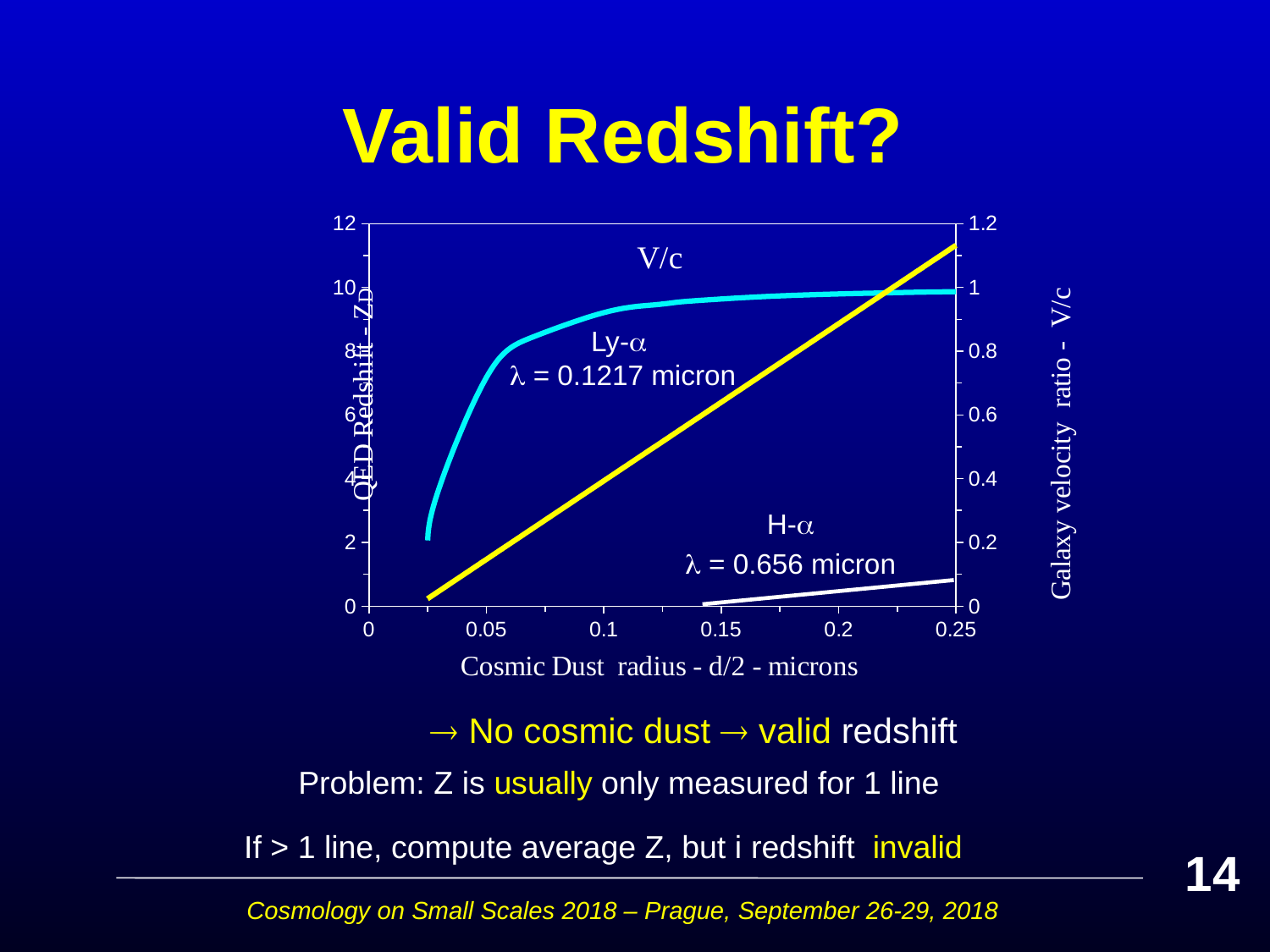
How many curves are plotted on the chart? 3 What kind of chart is shown on the slide? line chart Is the V/c value at a dust radius of 0.2 microns greater or less than 0.8 on the right axis? greater Does the V/c line rise or fall as the cosmic dust radius increases? rise What wavelength is given for the Ly-α curve? λ = 0.1217 micron What is the title of the x axis of the chart? Cosmic Dust radius - d/2 - microns Is the Ly-α redshift Z at a dust radius of 0.25 microns greater or less than 8? greater Is the H-α redshift Z at a dust radius of 0.25 microns greater or less than 2? less Does the Ly-α curve rise or fall as the cosmic dust radius increases? rise At a dust radius of 0.25 microns, which has the larger redshift Z, Ly-α or H-α? Ly-α